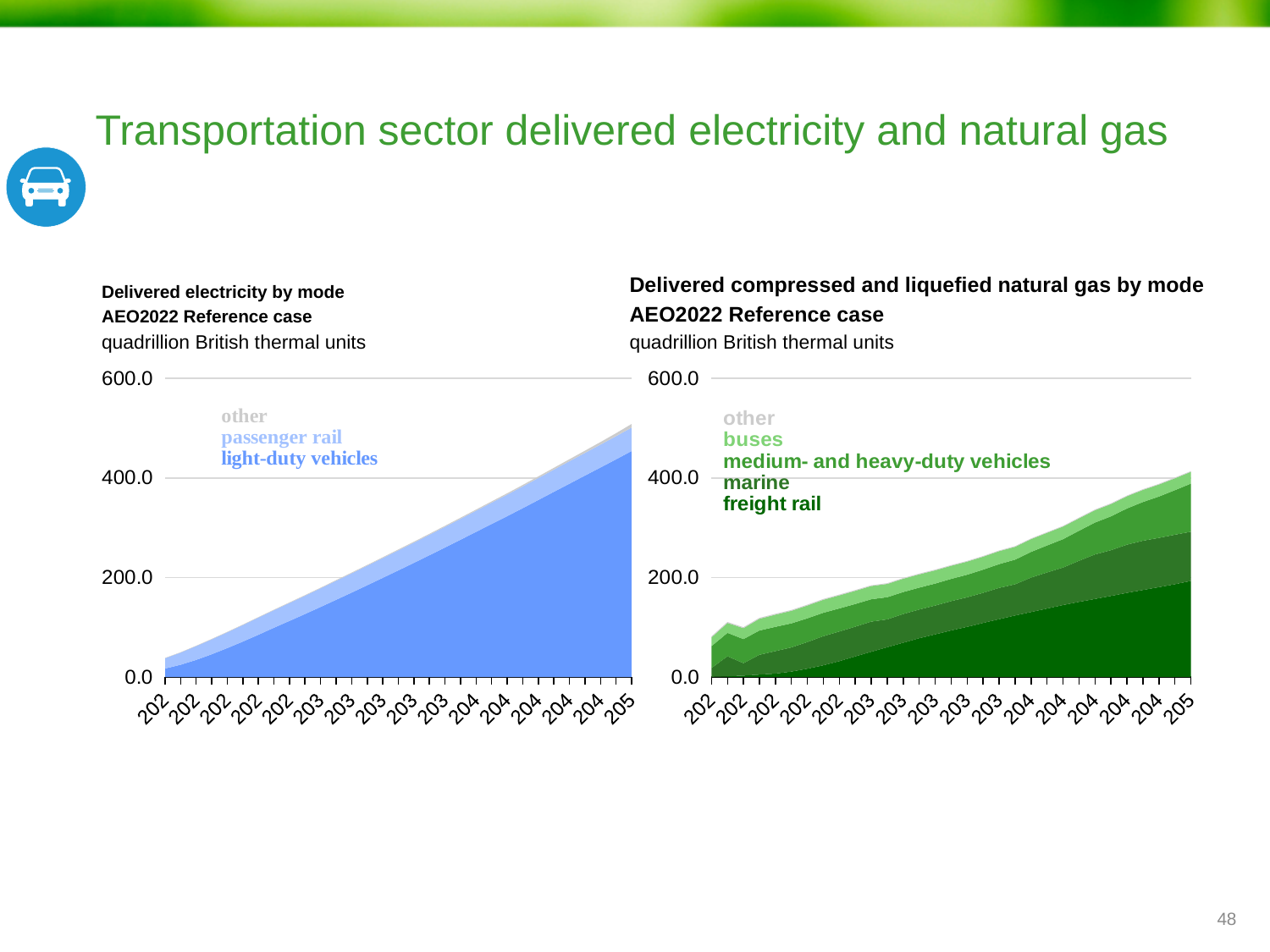
What kind of chart is the 'Delivered electricity by mode' chart on the left? Stacked area chart In the 'Delivered electricity by mode' chart, is the total at the start of the projection greater or less than 200.0? less At the end of the projection, which chart shows the larger total: 'Delivered electricity by mode' or 'Delivered compressed and liquefied natural gas by mode'? Delivered electricity by mode In the 'Delivered compressed and liquefied natural gas by mode' chart, does the total rise or fall along the x axis? Rise In the 'Delivered electricity by mode' chart, does total delivered electricity rise or fall over the projection period? Rise What unit is used on the y axis of both charts? quadrillion British thermal units How many series does the legend of the 'Delivered electricity by mode' chart list? 3 How many series does the legend of the 'Delivered compressed and liquefied natural gas by mode' chart list? 5 In the 'Delivered electricity by mode' chart, which mode accounts for the largest share of delivered electricity? light-duty vehicles In the 'Delivered compressed and liquefied natural gas by mode' chart, is the total at the end of the projection greater or less than 200.0? greater In the 'Delivered electricity by mode' chart, is the total at the end of the projection greater or less than 400.0? greater Which AEO2022 case do both charts show? Reference case